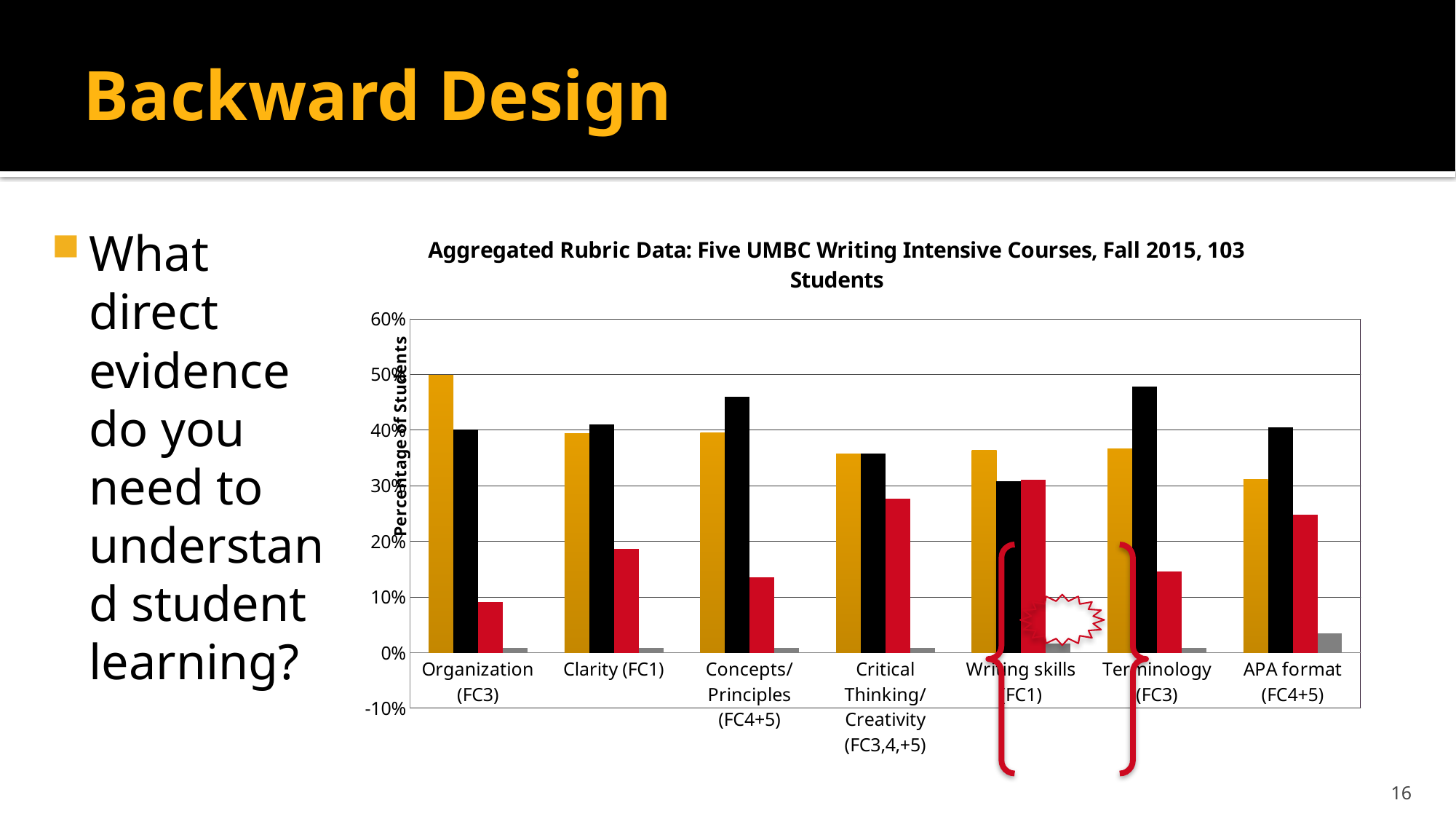
What kind of chart is shown on the slide? bar chart Which category has the tallest red bar? Writing skills (FC1) Is the value of the gold bar for Organization (FC3) greater or less than 40%? greater What is the label on the vertical axis of the chart? Percentage of Students For Organization (FC3), which is larger: the gold bar or the black bar? the gold bar Is the value of the red bar for Organization (FC3) greater or less than 20%? less What is the title of the chart? Aggregated Rubric Data: Five UMBC Writing Intensive Courses, Fall 2015, 103 Students Is the value of the red bar for Critical Thinking/Creativity (FC3,4,+5) greater or less than 20%? greater For Concepts/Principles (FC4+5), which is larger: the gold bar or the black bar? the black bar How many categories are shown along the x axis of the chart? 7 Which category has the tallest gold bar? Organization (FC3)